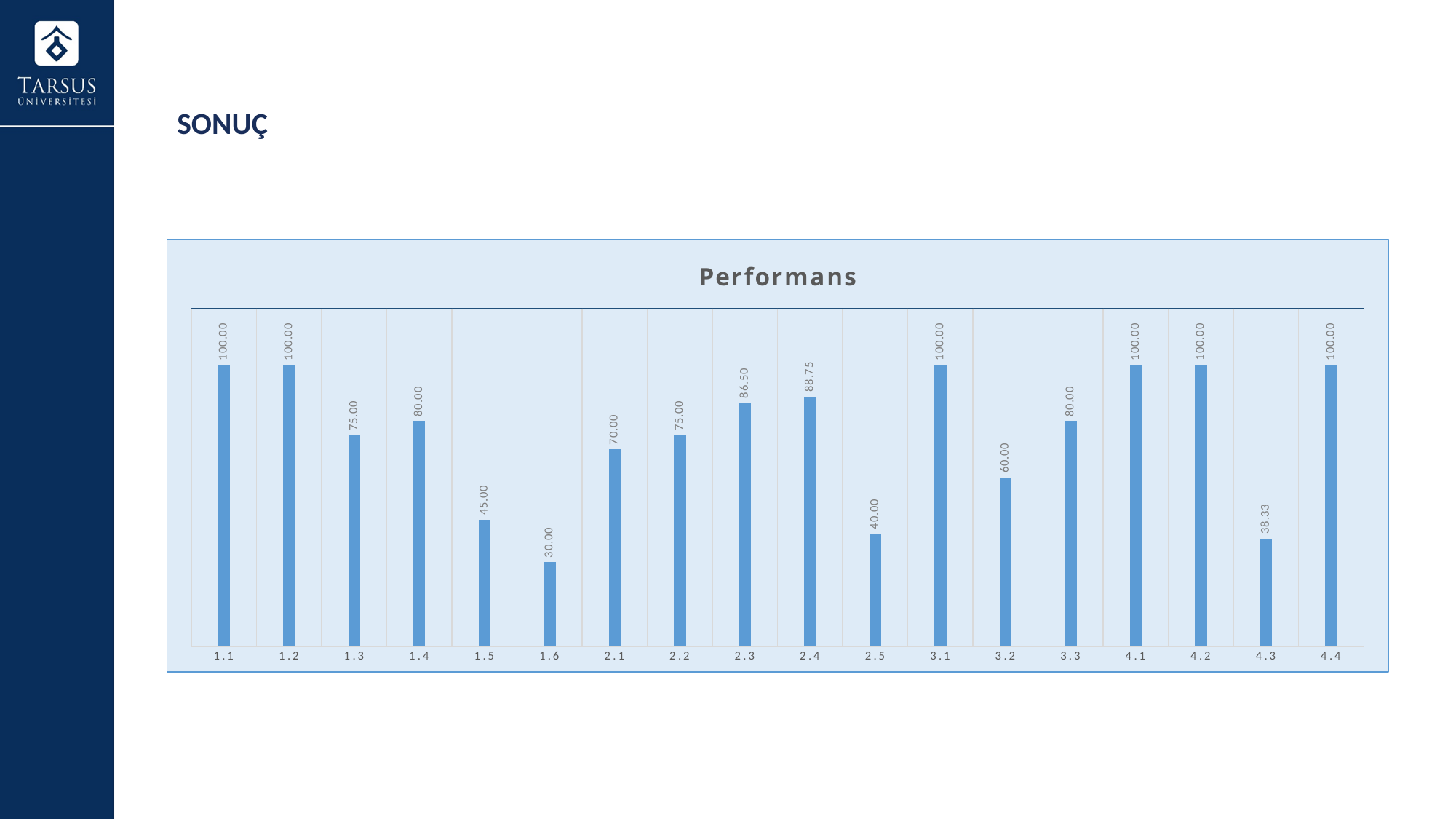
What is the difference between the values for 2.4 and 2.5 in the Performans chart? 48.75 How many categories are shown in the Performans chart? 18 What is the value for category 4.3 in the Performans chart? 38.33 What kind of chart is shown on the slide? Bar chart What is the value for category 2.3 in the Performans chart? 86.50 Which category has the lowest value in the Performans chart? 1.6 What is the value for category 2.4 in the Performans chart? 88.75 Which is larger in the Performans chart, the value for 3.2 or the value for 3.3? 3.3 What is the title of the chart on the slide? Performans What is the value for category 1.3 in the Performans chart? 75.00 What is the difference between the values for 1.4 and 1.5 in the Performans chart? 35.00 Which is larger in the Performans chart, the value for 2.1 or the value for 2.5? 2.1